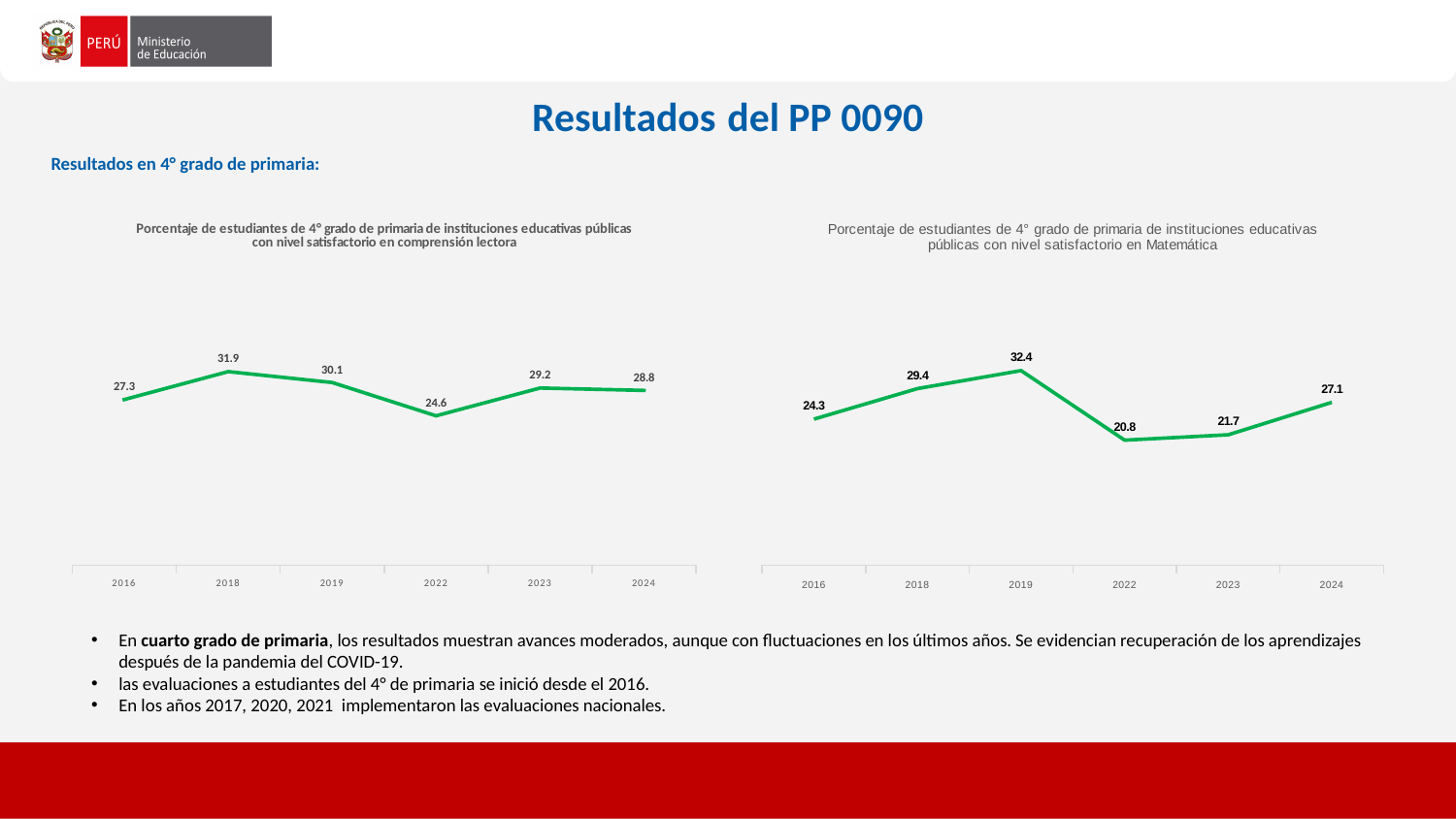
In the left chart (comprensión lectora), what is the value for 2016? 27.3 In the right chart (Matemática), what is the value for 2019? 32.4 In the left chart (comprensión lectora), what is the difference between the 2018 value and the 2022 value? 7.3 In the right chart (Matemática), which year has the lowest value? 2022 In the right chart (Matemática), what is the difference between the 2024 value and the 2023 value? 5.4 In the left chart (comprensión lectora), which year has the highest value? 2018 In the left chart (comprensión lectora), which year has the lowest value? 2022 What type of chart is the left chart (comprensión lectora)? line chart What colour is the line in the right chart (Matemática)? green In the right chart (Matemática), which is larger, the value for 2016 or the value for 2024? 2024 In the right chart (Matemática), do the values rise or fall from 2019 to 2022? fall In the left chart (comprensión lectora), how many years are plotted? 6